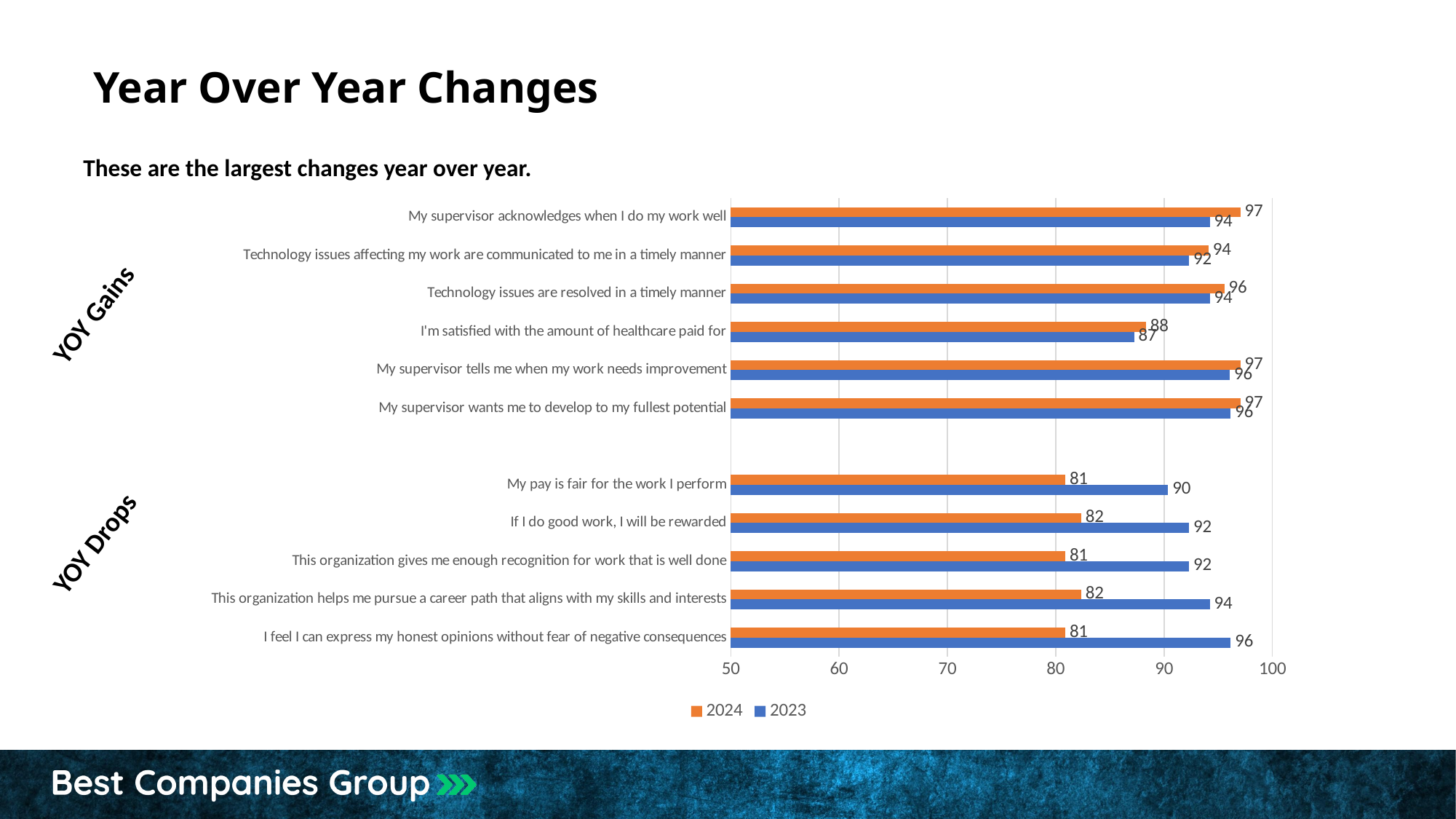
What is the 2023 value for "This organization helps me pursue a career path that aligns with my skills and interests"? 94 How many statements (categories) are plotted in the chart? 11 Which colour represents the 2024 series in the chart? orange For "If I do good work, I will be rewarded", which year has the larger value, 2023 or 2024? 2023 What is the difference between the 2024 and 2023 values for "Technology issues are resolved in a timely manner"? 2 What is the 2023 value for "My pay is fair for the work I perform"? 90 How many series does the legend list? 2 Which statement has the lowest 2023 value? I'm satisfied with the amount of healthcare paid for What kind of chart is shown on the slide? bar chart What is the 2024 value for "My supervisor acknowledges when I do my work well"? 97 What is the difference between the 2023 and 2024 values for "I feel I can express my honest opinions without fear of negative consequences"? 15 What is the 2024 value for "I'm satisfied with the amount of healthcare paid for"? 88